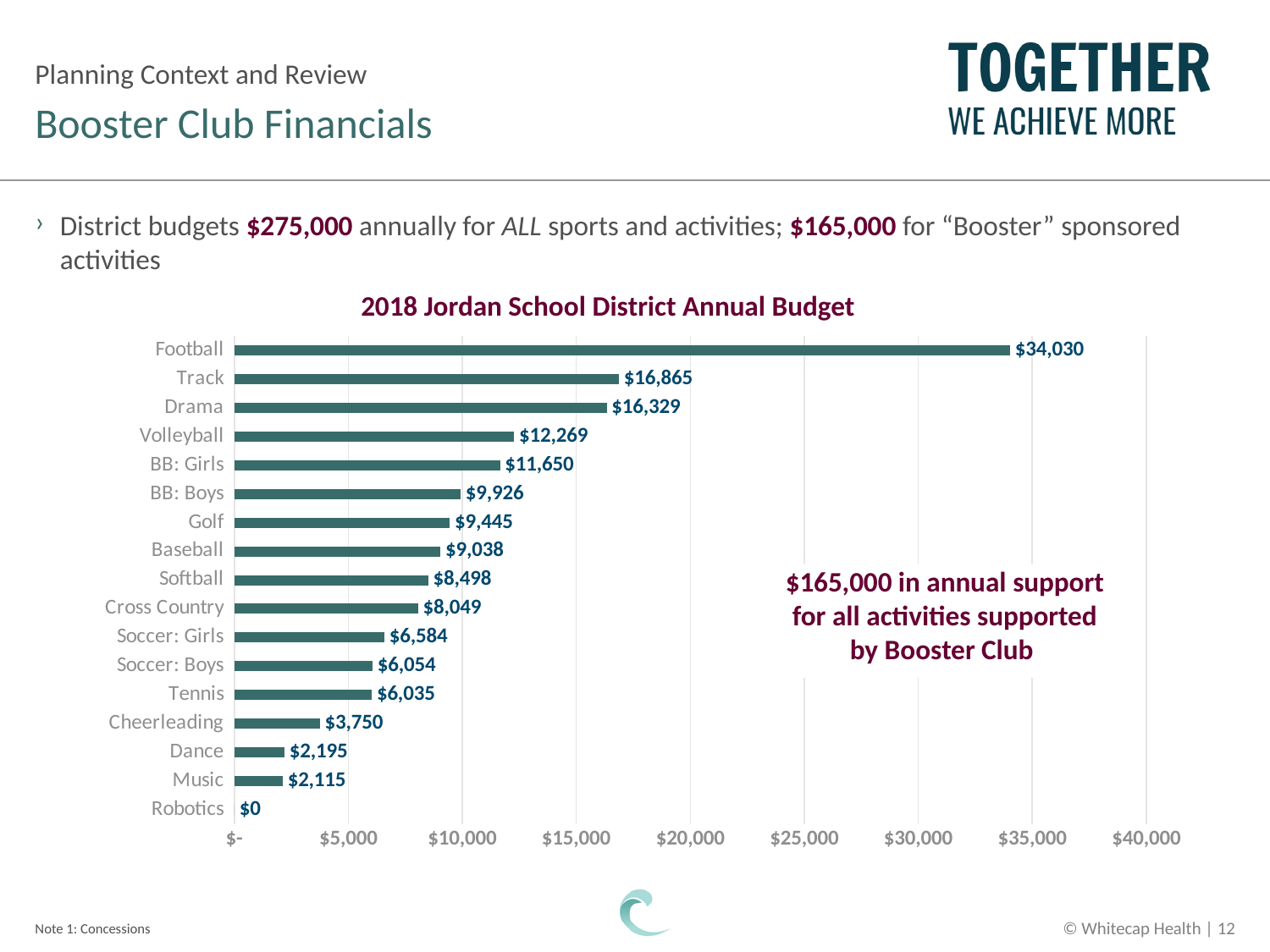
How many categories are shown in the chart? 17 Which category has the highest budget? Football What is the budget value for Volleyball? $12,269 What is the budget value for Football? $34,030 What is the budget value for Cheerleading? $3,750 What is the difference between the budgets for Track and Drama? $536 Which category has the lowest budget? Robotics What is the difference between the budgets for Football and Track? $17,165 What kind of chart is shown on the slide? Bar chart What is the title of the chart? 2018 Jordan School District Annual Budget Which has a larger budget, Golf or Baseball? Golf Is the value for BB: Girls greater or less than $10,000? greater